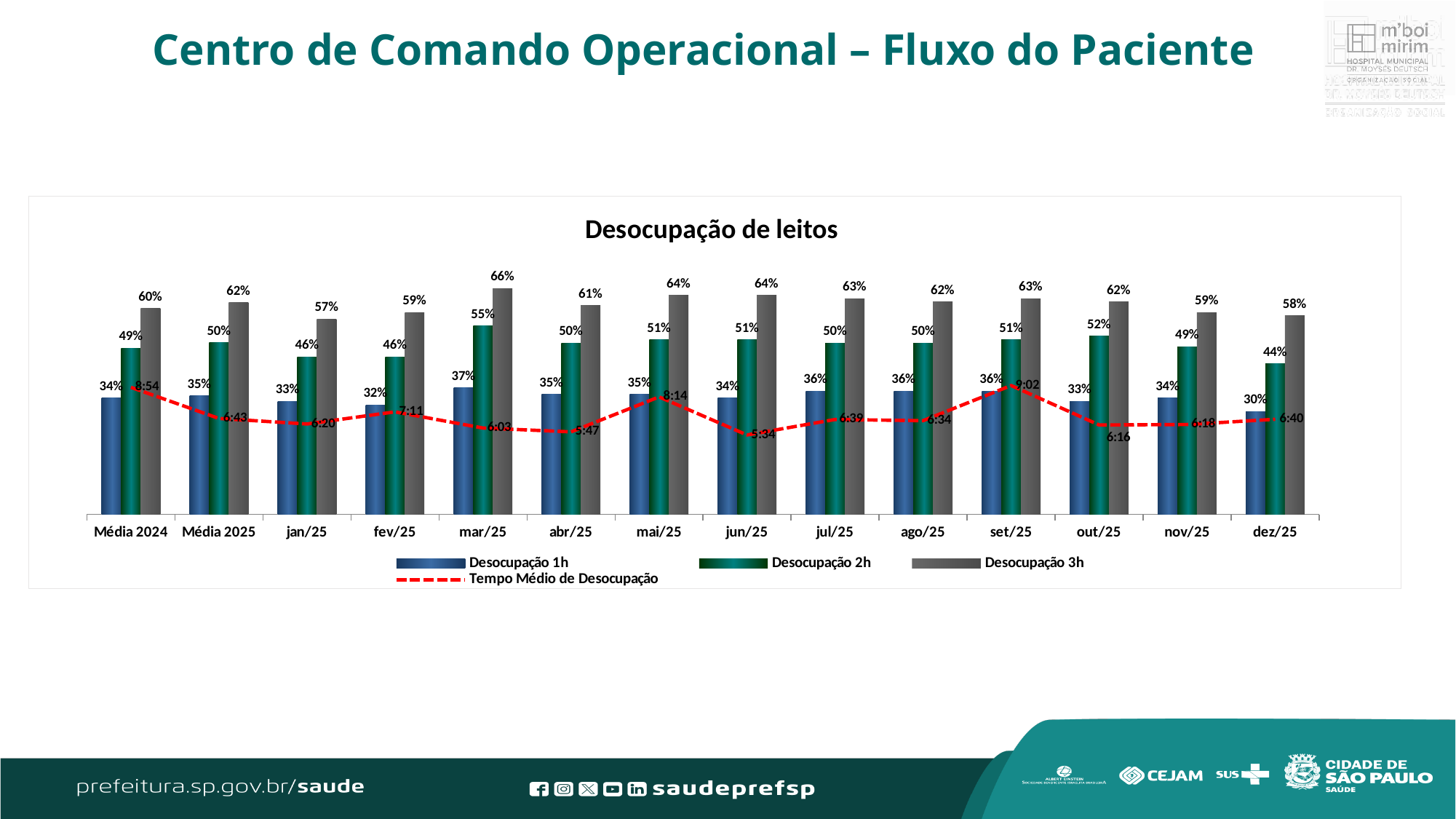
Which is larger, the Desocupação 2h value for out/25 or for nov/25? out/25 Which category has the lowest Tempo Médio de Desocupação? jun/25 What is the title of the chart? Desocupação de leitos What is the Tempo Médio de Desocupação value for set/25? 9:02 What is the Desocupação 1h value for dez/25? 30% What kind of chart is this? Combined bar and line chart How many series does the legend list? 4 How many categories are shown on the x axis? 14 Which category has the highest Desocupação 2h value? mar/25 What is the difference between the Desocupação 3h and Desocupação 1h values for Média 2025? 27% Which category has the lowest Desocupação 3h value? jan/25 What is the Desocupação 3h value for mar/25? 66%